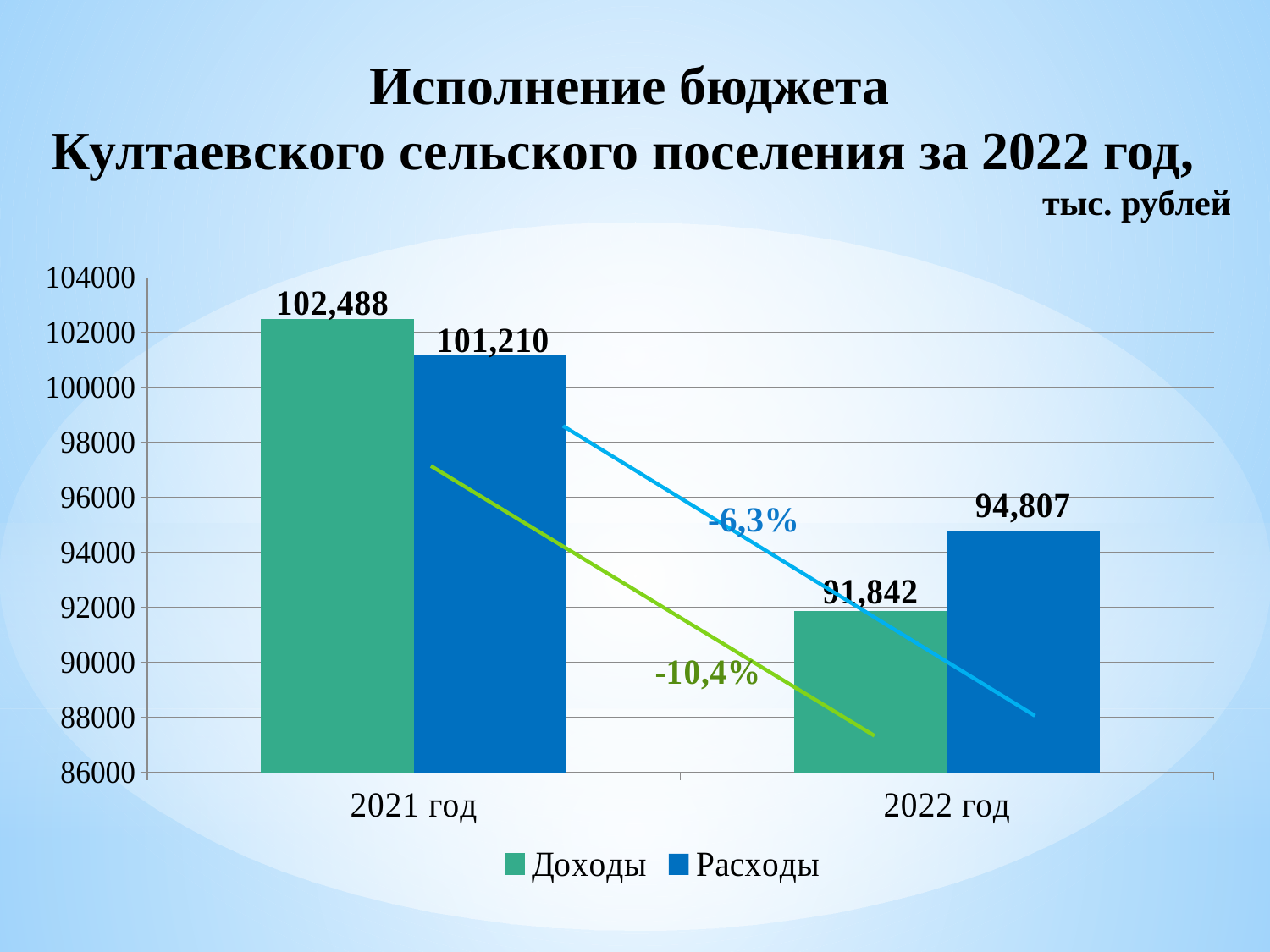
What is the value of Расходы for 2021 год? 101,210 In 2021 год, which is larger: Доходы or Расходы? Доходы How many year categories are shown on the x axis? 2 What is the difference between Доходы and Расходы in 2022 год? 2,965 What percentage change is annotated next to the green trend line for Доходы? -10,4% What is the value of Доходы for 2021 год? 102,488 What kind of chart is shown on the slide? Bar chart What is the value of Расходы for 2022 год? 94,807 Which bar has the lowest value on the chart? Доходы, 2022 год What is the value of Доходы for 2022 год? 91,842 How many series does the legend list? 2 Which bar has the highest value on the chart? Доходы, 2021 год